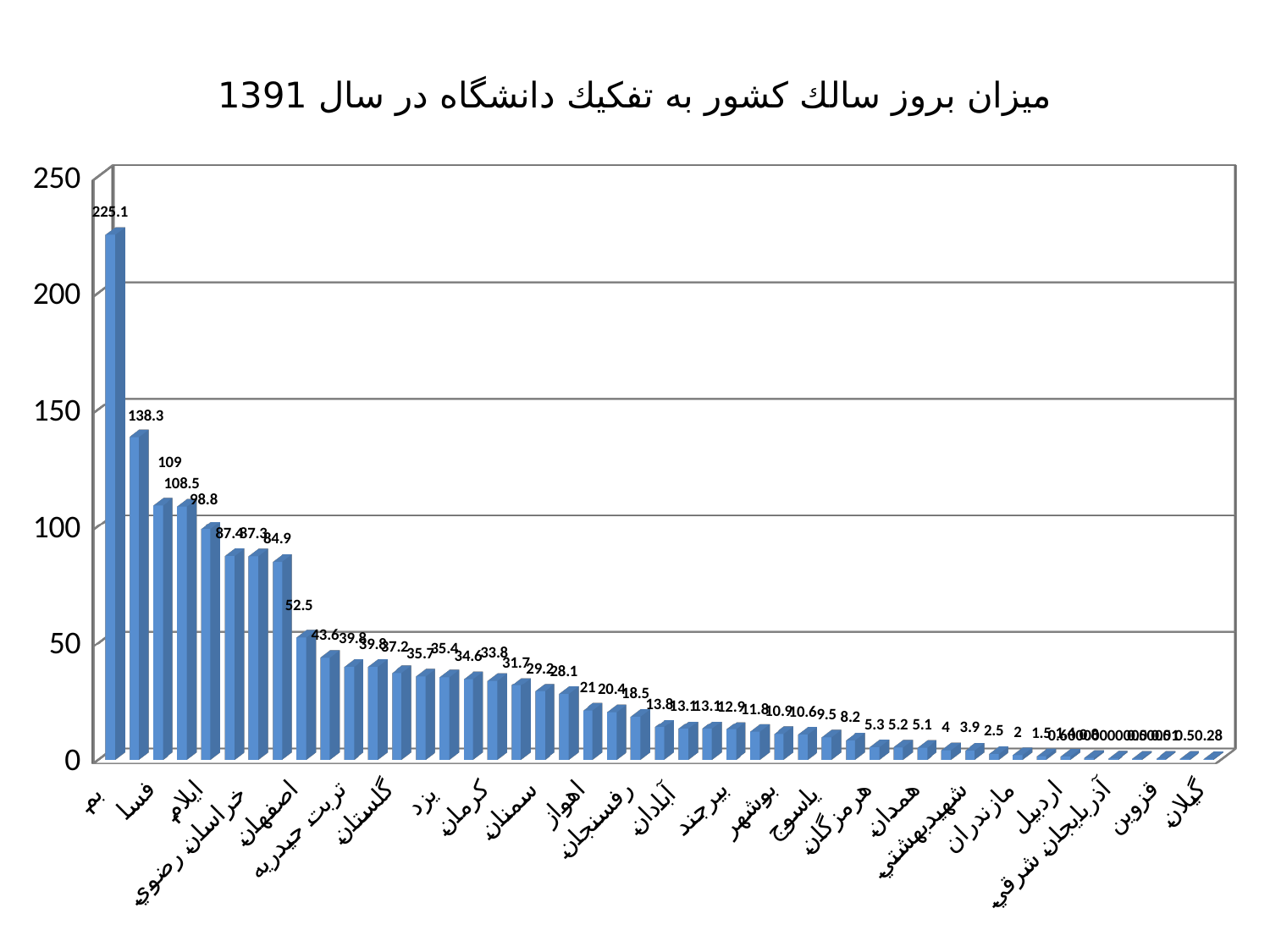
Is the value for بم greater or less than 200? greater What is the title of the chart? ميزان بروز سالك كشور به تفكيك دانشگاه در سال 1391 Which has a larger value, اصفهان or گيلان? اصفهان Is the value for فسا greater or less than 100? greater What is the value for گيلان? 0.28 Do the values rise or fall moving from left to right along the x axis? fall What type of chart is shown on the slide? bar chart Which category has the lowest value in the chart? گيلان Which has a larger value, بم or فسا? بم Is the value for گيلان greater or less than 50? less What is the value for بم? 225.1 Which category has the highest value in the chart? بم